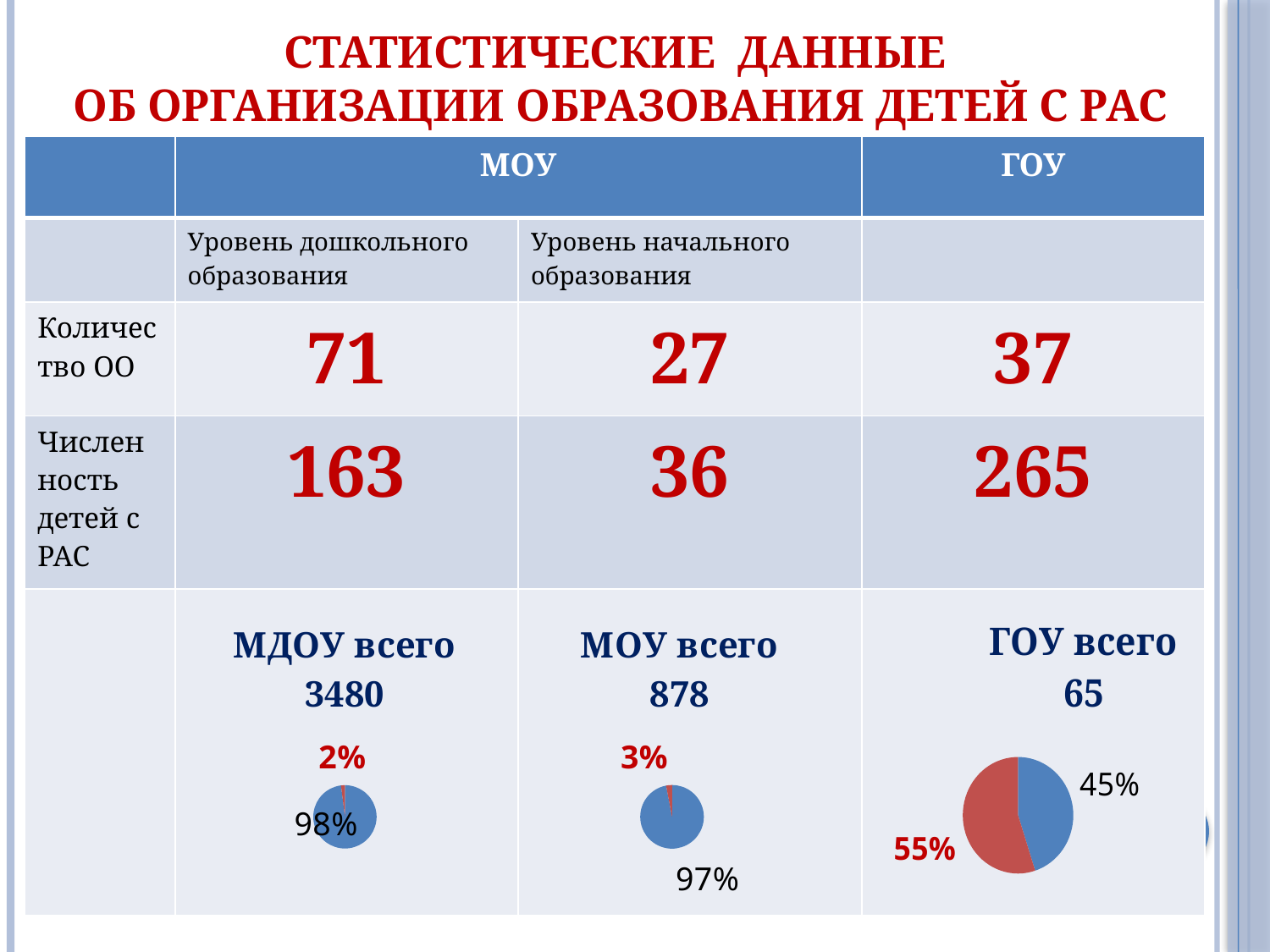
In the pie chart under "ГОУ всего 65", what share does the red slice represent? 55% In the pie chart under "МДОУ всего 3480", what share does the red slice represent? 2% How many slices does the pie chart under "МОУ всего 878" have? 2 In the pie chart under "ГОУ всего 65", what is the difference between the red slice's share and the blue slice's share? 10% In the pie chart under "МОУ всего 878", what share does the red slice represent? 3% In the pie chart under "ГОУ всего 65", which slice is larger, the red one or the blue one? the red one Which of the three pie charts has the largest red slice? ГОУ всего 65 How many pie charts are shown on the slide? 3 What kind of chart is shown under "МДОУ всего 3480"? pie chart